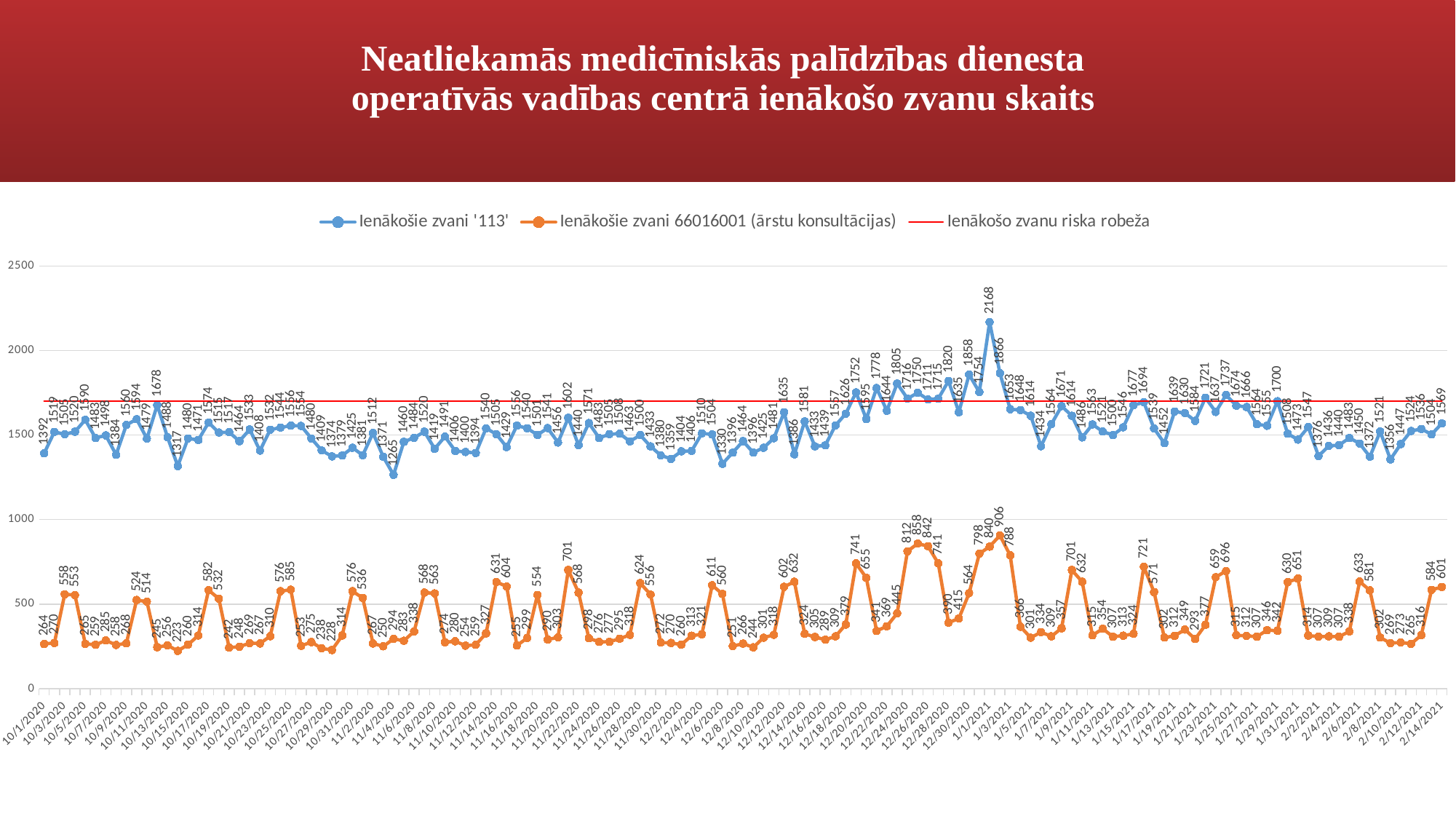
How many series does the legend list? 3 Which series has higher values throughout the chart, Ienākošie zvani '113' or Ienākošie zvani 66016001 (ārstu konsultācijas)? Ienākošie zvani '113' What is the lowest value of the series Ienākošie zvani 66016001 (ārstu konsultācijas)? 223 What colour is the line for Ienākošo zvanu riska robeža? red What is the difference between the peak value of Ienākošie zvani '113' (2168) and the peak value of Ienākošie zvani 66016001 (906)? 1262 What is the highest value of the series Ienākošie zvani '113'? 2168 What is the highest value of the series Ienākošie zvani 66016001 (ārstu konsultācijas)? 906 What is the lowest value of the series Ienākošie zvani '113'? 1265 What is the value of Ienākošie zvani '113' on 10/1/2020? 1392 What kind of chart is shown on the slide? line chart What is the value of Ienākošie zvani 66016001 (ārstu konsultācijas) on 10/1/2020? 264 Is the highest value of Ienākošie zvani 66016001 (ārstu konsultācijas) greater or less than 1000? less